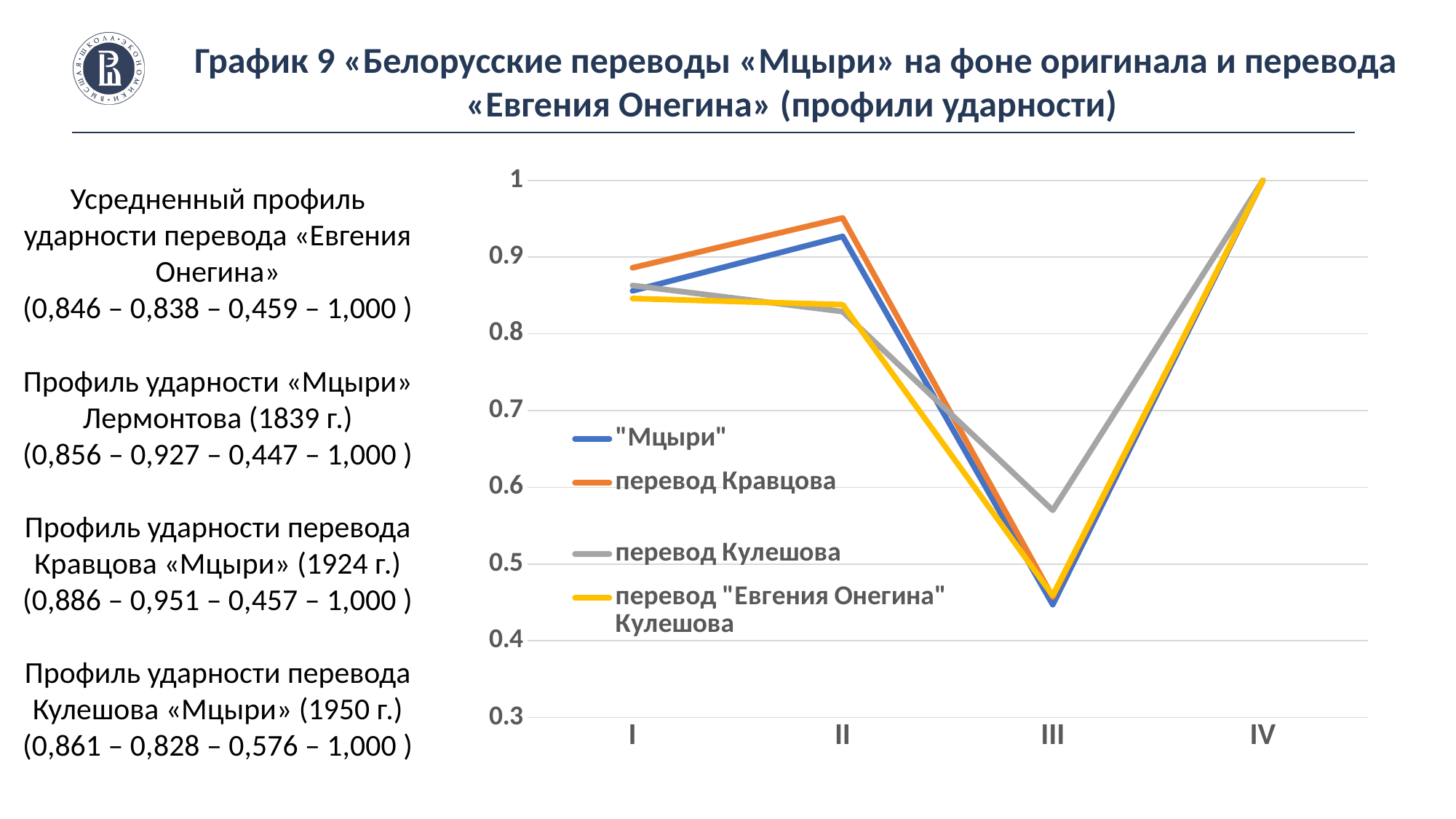
Is the value of the перевод Кулешова series at position III greater or less than 0.5? greater How many series does the chart legend list? 4 Do the values of the series rise or fall from position II to position III? fall How many positions are shown on the x axis of the chart? 4 What is the value of the "Мцыри" series at position III? 0,447 What kind of chart is shown on the slide? line chart What value do all four series reach at position IV? 1 At which position does the "Мцыри" series reach its lowest value? III What is the value of the перевод Кравцова series at position II? 0,951 What is the value of the перевод Кулешова series at position III? 0,576 Which series has the highest value at position III? перевод Кулешова At position II, which is larger: перевод Кравцова or перевод Кулешова? перевод Кравцова